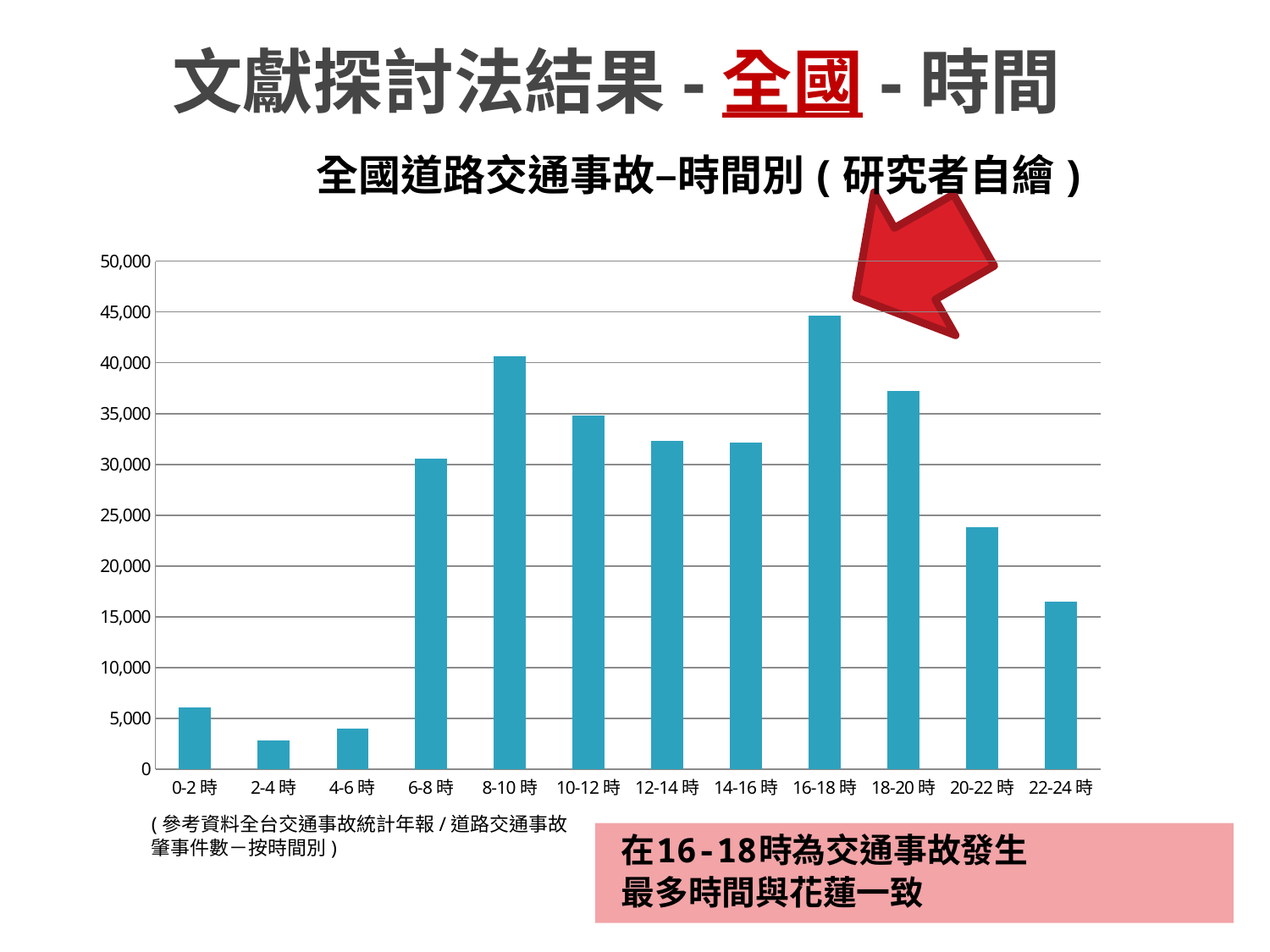
Is the value for 20-22時 greater or less than 25,000? less Is the value for 22-24時 greater or less than 15,000? greater Do the values rise or fall from 16-18時 through 22-24時? fall Which time period has the highest number of traffic accidents? 16-18時 Is the value for 16-18時 greater or less than 40,000? greater What is the title of the chart? 全國道路交通事故–時間別（研究者自繪） How many time-period categories are shown on the x axis? 12 What kind of chart is shown on the slide? bar chart Which time period has the lowest number of traffic accidents? 2-4時 Which is larger, the value for 8-10時 or the value for 18-20時? 8-10時